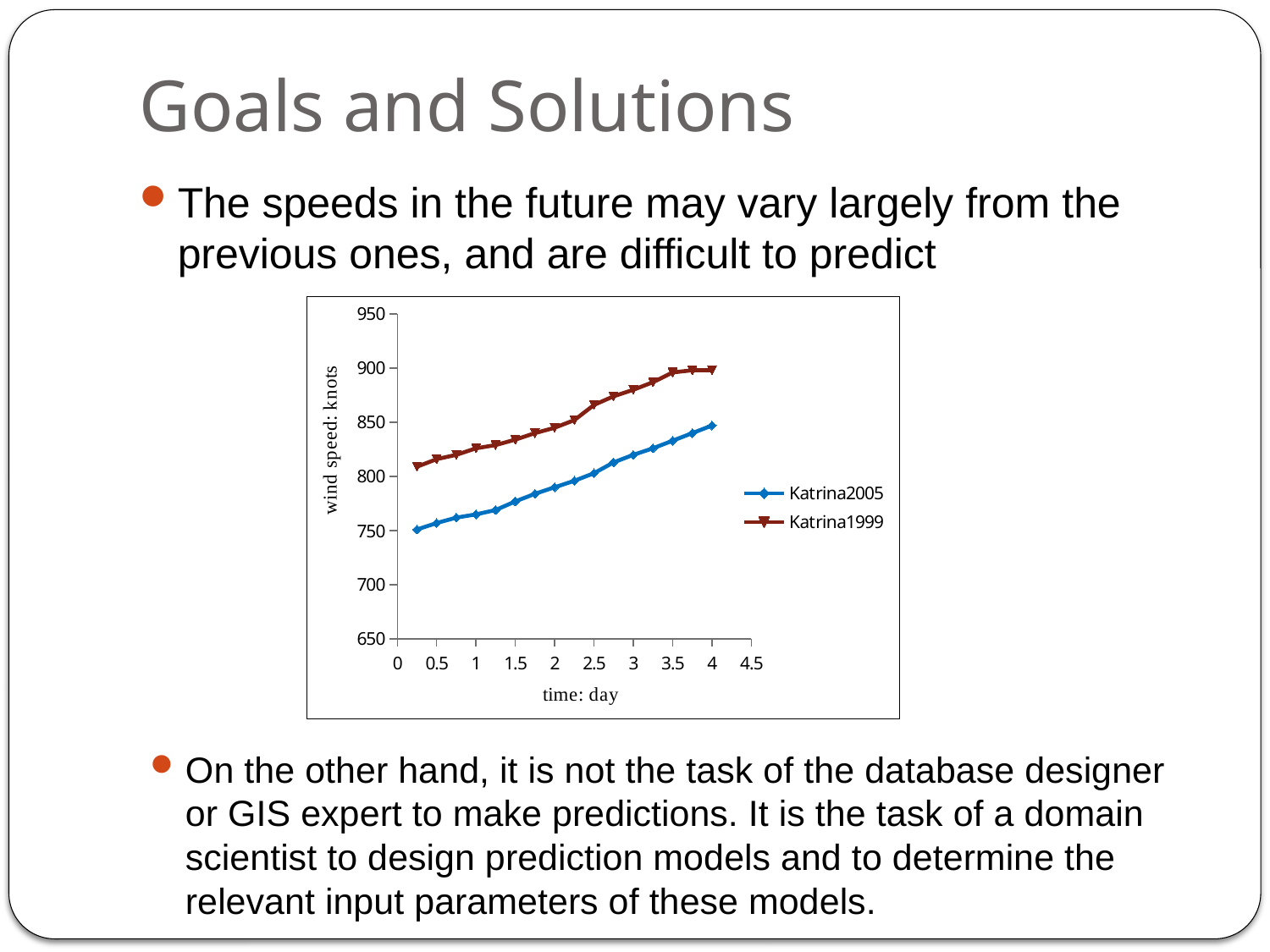
Do the wind speed values for Katrina1999 rise or fall as time increases? rise What is the label of the horizontal axis? time: day Do the wind speed values for Katrina2005 rise or fall as time increases? rise Is the wind speed for Katrina1999 at day 0.5 greater or less than 800? greater What kind of chart is shown on the slide? line chart How many series does the legend list? 2 Is the wind speed for Katrina1999 at day 3 greater or less than 850? greater Which series has higher wind speed values throughout the chart, Katrina2005 or Katrina1999? Katrina1999 What is the label of the vertical axis? wind speed: knots Is the wind speed for Katrina2005 at day 3 greater or less than 800? greater